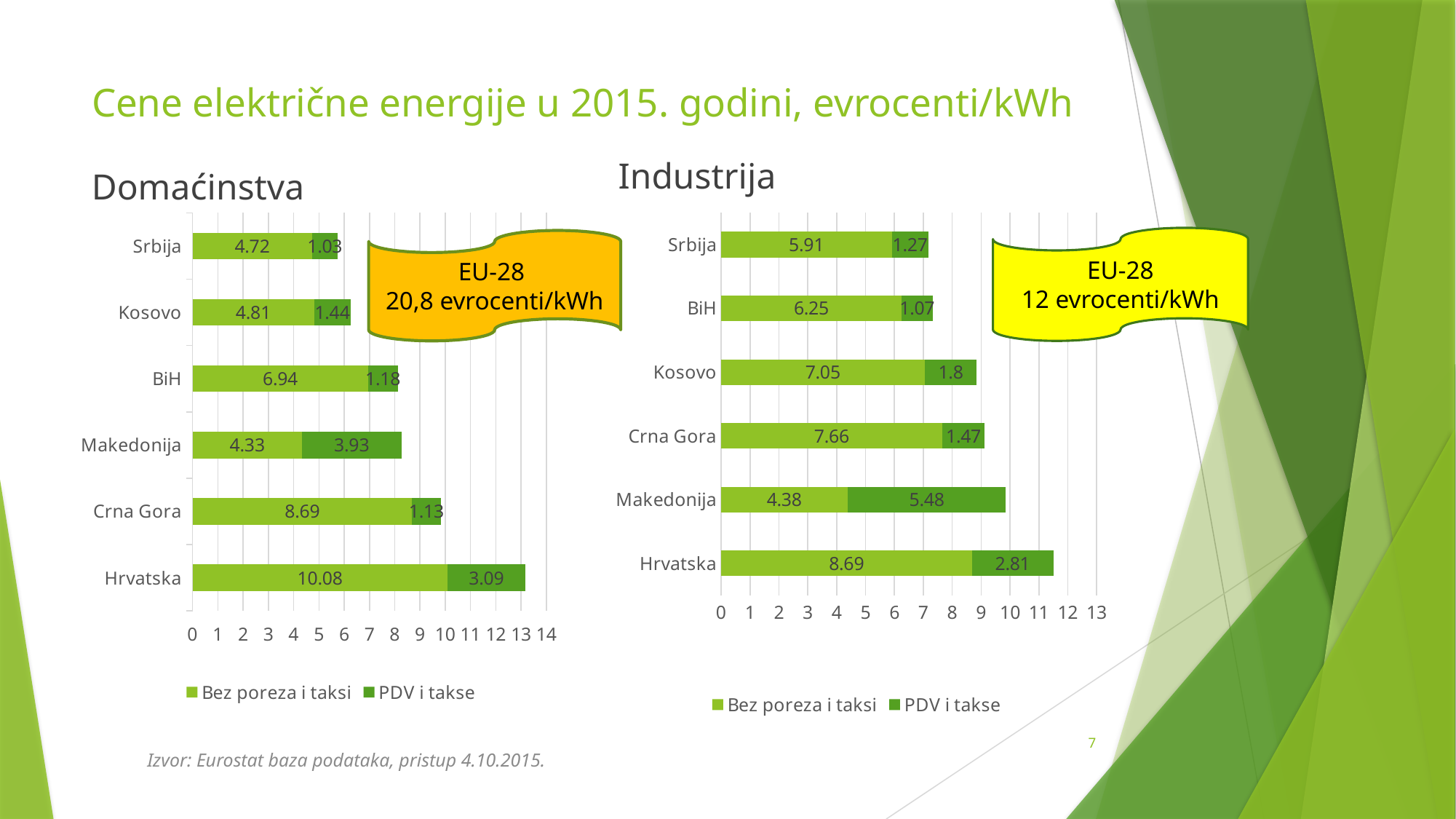
In the Industrija chart, what is the difference between the 'Bez poreza i taksi' values for Crna Gora and Srbija? 1.75 How many series does the legend of the Domaćinstva chart list? 2 What EU-28 value is shown in the callout next to the Domaćinstva chart? 20,8 evrocenti/kWh In the Industrija chart, what is the total of the stacked bar for Hrvatska? 11.5 In the Industrija chart, which country has the lowest 'Bez poreza i taksi' value? Makedonija How many countries are shown in the Industrija chart? 6 What type of chart is the Industrija chart? Stacked bar chart In the Domaćinstva chart, which country has the highest 'Bez poreza i taksi' value? Hrvatska In the Industrija chart, what is the 'PDV i takse' value for Makedonija? 5.48 In the Domaćinstva chart, which is larger: the 'PDV i takse' value for Makedonija or for Kosovo? Makedonija In the Domaćinstva chart, what is the total of the stacked bar for Hrvatska? 13.17 In the Domaćinstva chart, what is the 'Bez poreza i taksi' value for Hrvatska? 10.08